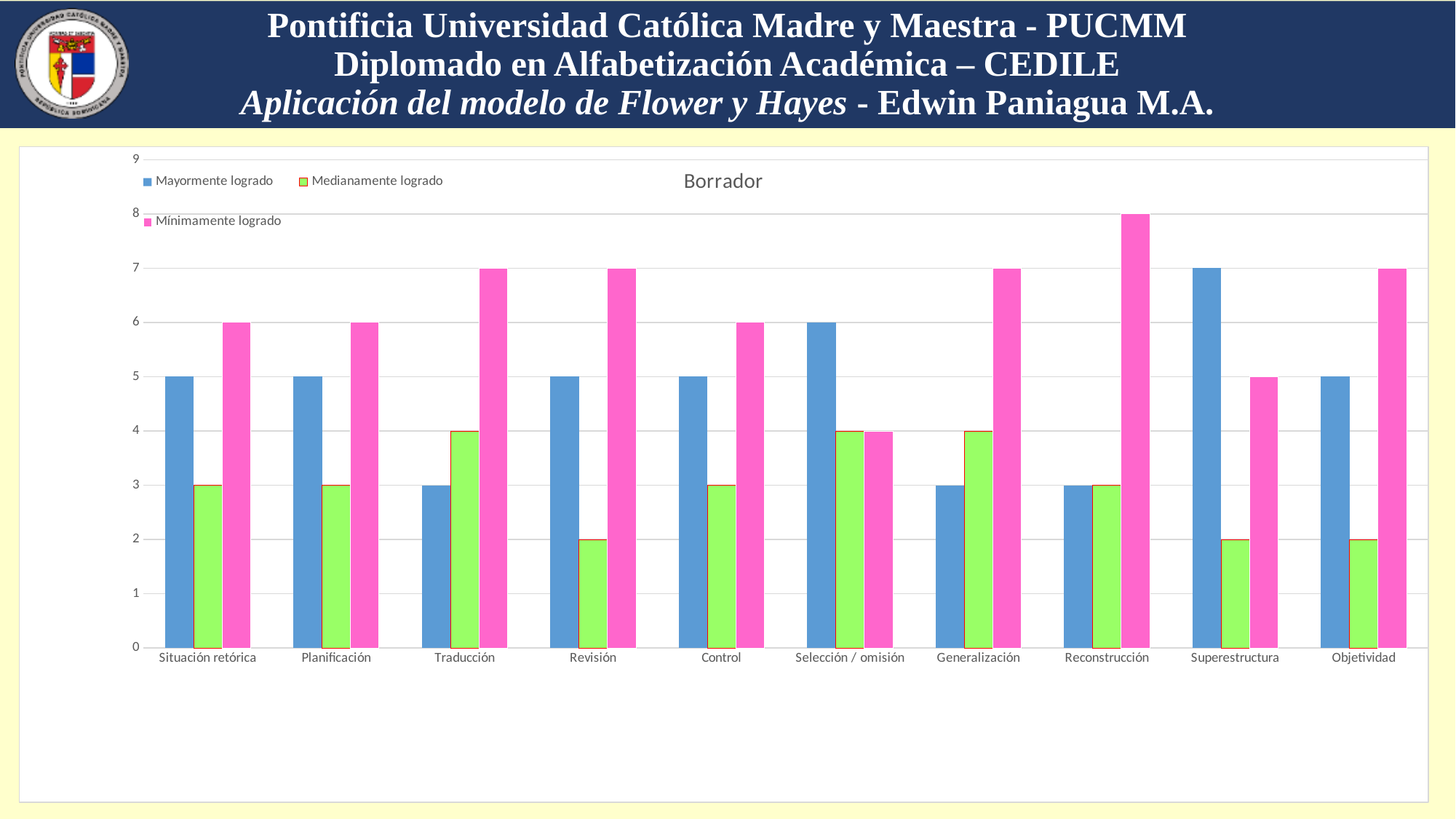
What is the difference between Mínimamente logrado and Mayormente logrado for Reconstrucción? 5 What kind of chart is shown on the slide? bar chart Which category has the highest Mayormente logrado value? Superestructura What is the value of Mayormente logrado for Superestructura? 7 What is the value of Medianamente logrado for Revisión? 2 What is the value of Mínimamente logrado for Reconstrucción? 8 How many categories are shown on the x axis? 10 Which category has the highest Mínimamente logrado value? Reconstrucción For Selección / omisión, which is larger: Mayormente logrado or Medianamente logrado? Mayormente logrado Is the Mínimamente logrado value for Traducción greater or less than 5? greater What is the title of the chart? Borrador How many series does the legend list? 3